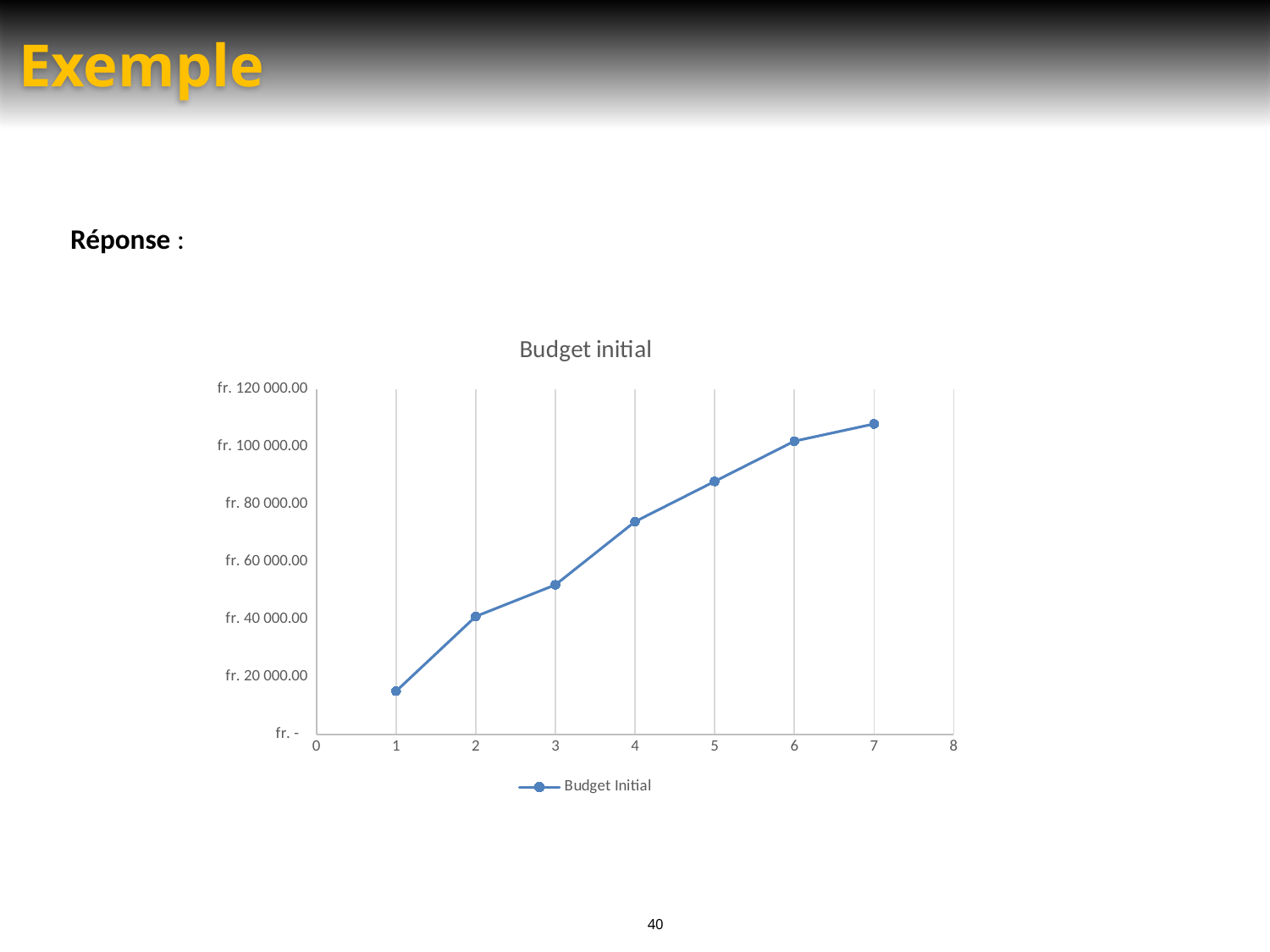
Is the value at x = 7 greater or less than fr. 100 000.00? greater Which is larger, the value at x = 5 or the value at x = 3? x = 5 Do the values rise or fall as x increases from 1 to 7? rise At which x value is the Budget Initial lowest? 1 Is the value at x = 4 greater or less than fr. 60 000.00? greater What is the name of the series shown in the legend? Budget Initial How many series does the legend list? 1 What is the title of the chart? Budget initial At which x value is the Budget Initial highest? 7 Is the value at x = 1 greater or less than fr. 20 000.00? less What kind of chart is shown on the slide? line chart How many data points are plotted on the line? 7